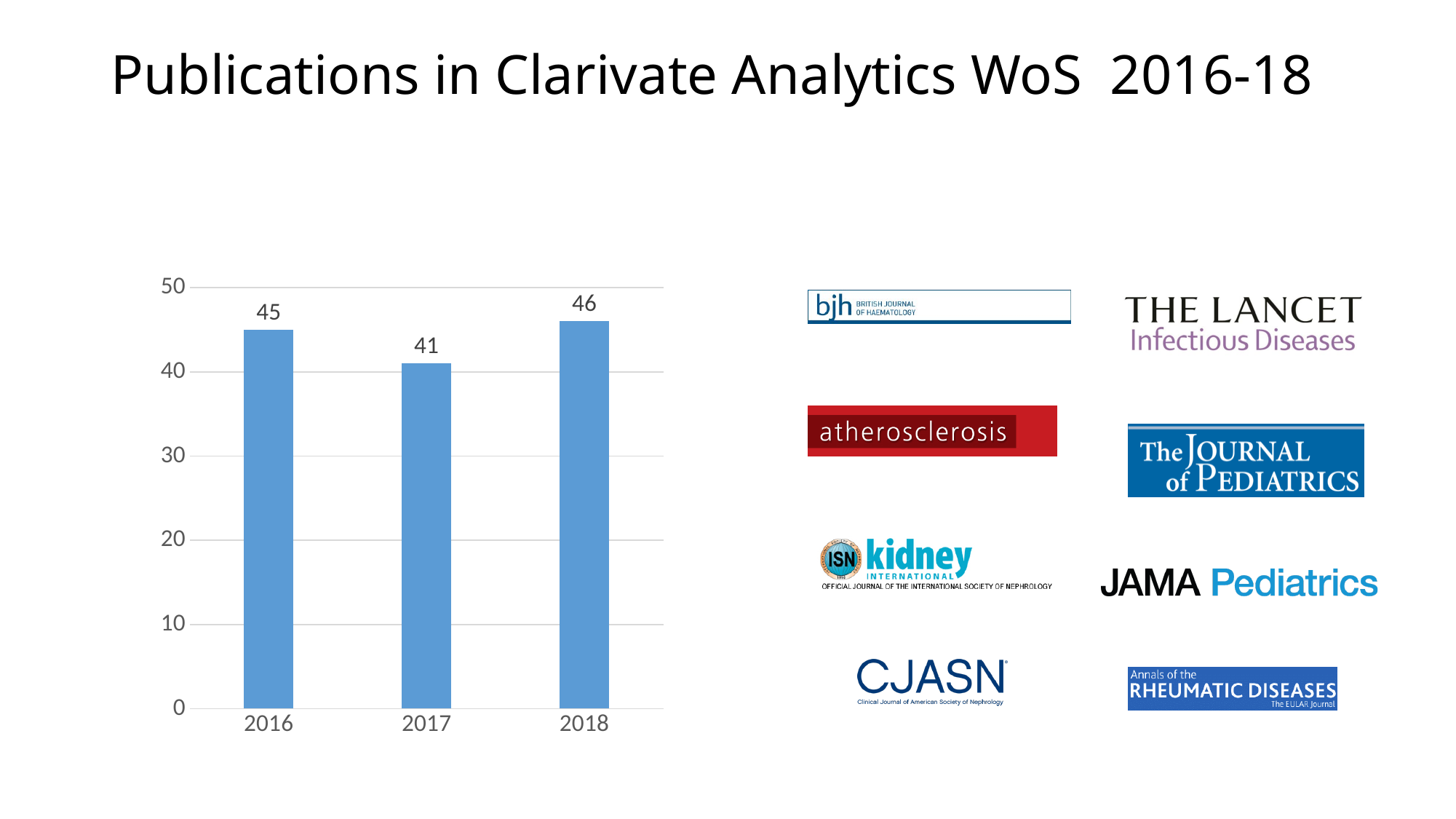
What is the value for 2018? 46 What is the value for 2017? 41 Which is larger, the value for 2016 or the value for 2017? 2016 How many years are shown on the x axis? 3 What is the difference between the values for 2018 and 2017? 5 What is the value for 2016? 45 Which year has the lowest value? 2017 What is the title of the slide? Publications in Clarivate Analytics WoS 2016-18 Is the value for 2017 greater or less than 40? greater Which year has the highest value? 2018 What is the difference between the values for 2016 and 2017? 4 What kind of chart is shown on the slide? bar chart